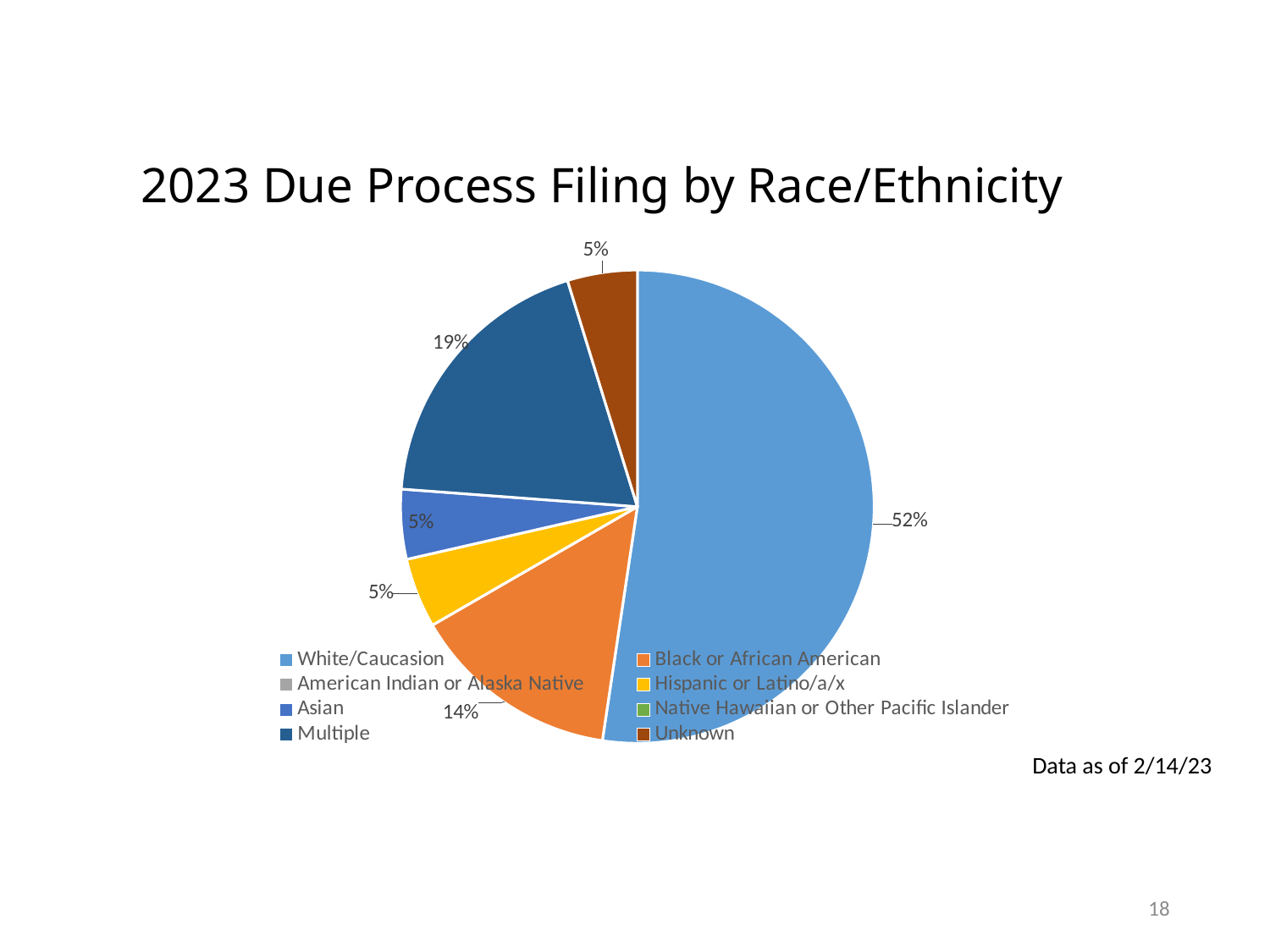
What percentage of the pie is Black or African American? 14% What percentage of the pie is Unknown? 5% How many categories does the legend list? 8 What kind of chart is shown on the slide? pie chart Which slice is larger, Black or African American or Multiple? Multiple What is the title of the chart? 2023 Due Process Filing by Race/Ethnicity What percentage of the pie is White/Caucasion? 52% What is the difference in percentage points between the White/Caucasion slice and the Multiple slice? 33 What percentage of the pie is Asian? 5% Which category has the largest slice of the pie? White/Caucasion What is the combined share of the Black or African American and Hispanic or Latino/a/x slices? 19% What percentage of the pie is Multiple? 19%